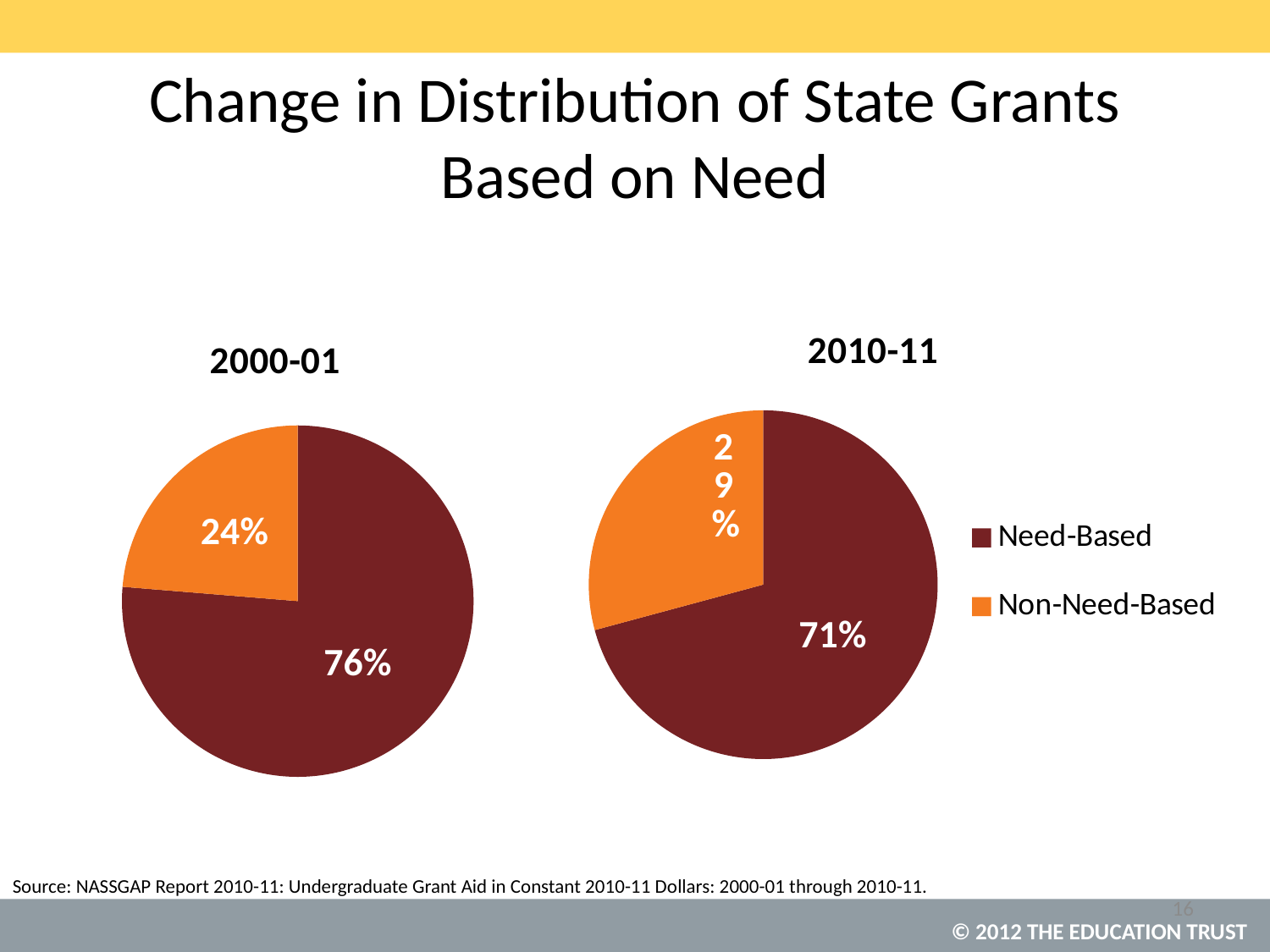
What colour represents Non-Need-Based in the pie charts? Orange In the 2010-11 pie chart, what share of state grants is Non-Need-Based? 29% In the 2010-11 pie chart, which category has the smallest slice? Non-Need-Based How many slices does the 2000-01 pie chart have? 2 What type of chart is used for the 2010-11 data? Pie chart Is the Need-Based share larger in the 2000-01 chart or the 2010-11 chart? 2000-01 In the 2010-11 pie chart, what share of state grants is Need-Based? 71% In the 2000-01 pie chart, what is the difference between the Need-Based and Non-Need-Based shares? 52% In the 2000-01 pie chart, which category has the largest slice? Need-Based In the 2000-01 pie chart, what share of state grants is Need-Based? 76% In the 2000-01 pie chart, what share of state grants is Non-Need-Based? 24% How many entries does the legend list? 2